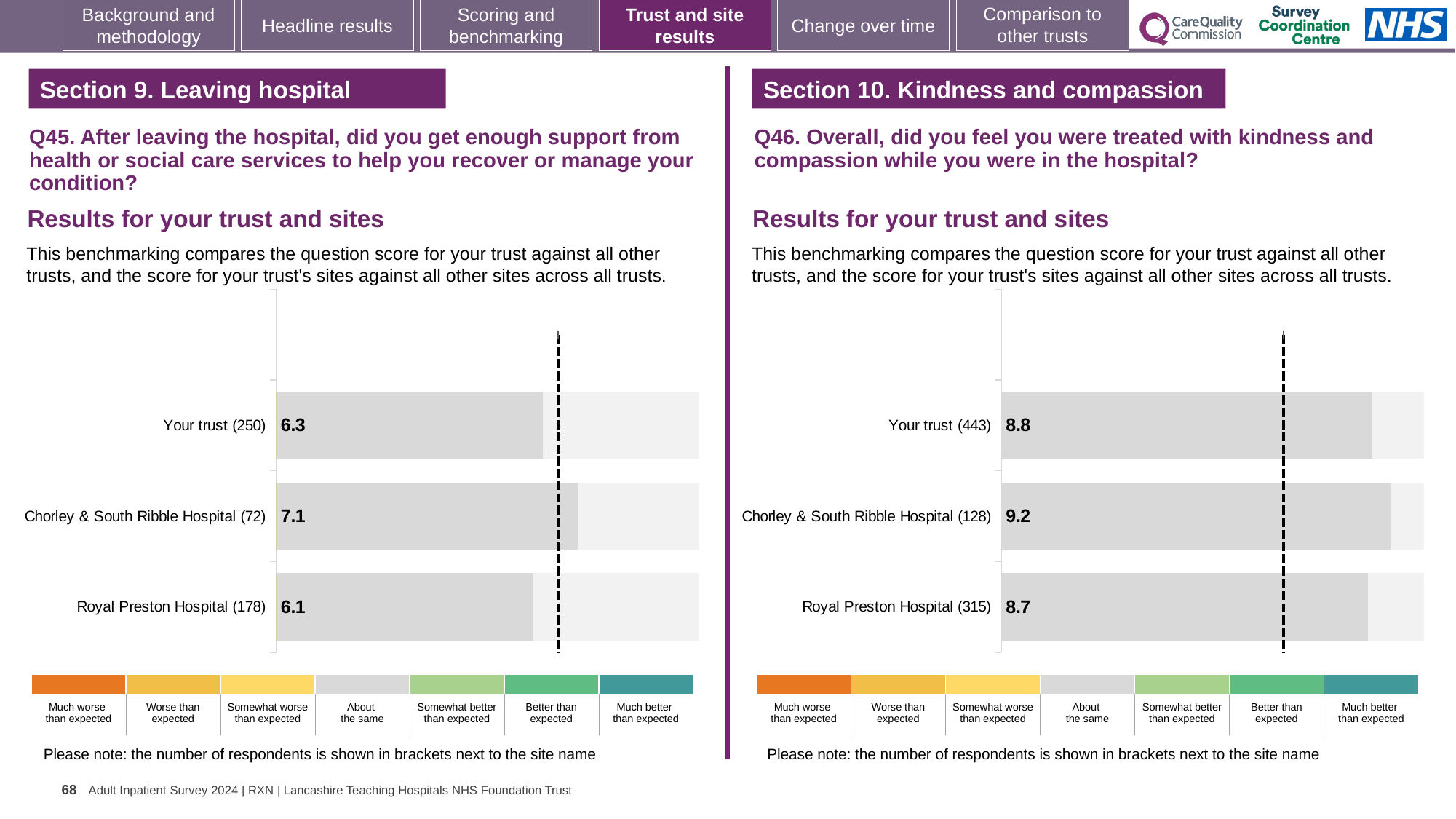
In the Q46 chart (right), which has the larger score, Your trust or Royal Preston Hospital? Your trust In the Q46 chart (right), what is the score for Your trust? 8.8 In the Q46 chart (right), which site or trust has the highest score? Chorley & South Ribble Hospital In the Q46 chart (right), how many respondents are shown for Chorley & South Ribble Hospital? 128 In the Q45 chart (left), which site or trust has the lowest score? Royal Preston Hospital In the Q46 chart (right), what is the difference between the scores for Chorley & South Ribble Hospital and Your trust? 0.4 In the Q45 chart (left), what is the score for Chorley & South Ribble Hospital? 7.1 In the Q45 chart (left), how many respondents are shown for Royal Preston Hospital? 178 What kind of chart is used for the Q45 results (left)? Bar chart In the Q45 chart (left), what is the difference between the scores for Chorley & South Ribble Hospital and Royal Preston Hospital? 1.0 How many bars are plotted in the Q46 chart (right)? 3 In the Q45 chart (left), what is the score for Your trust? 6.3